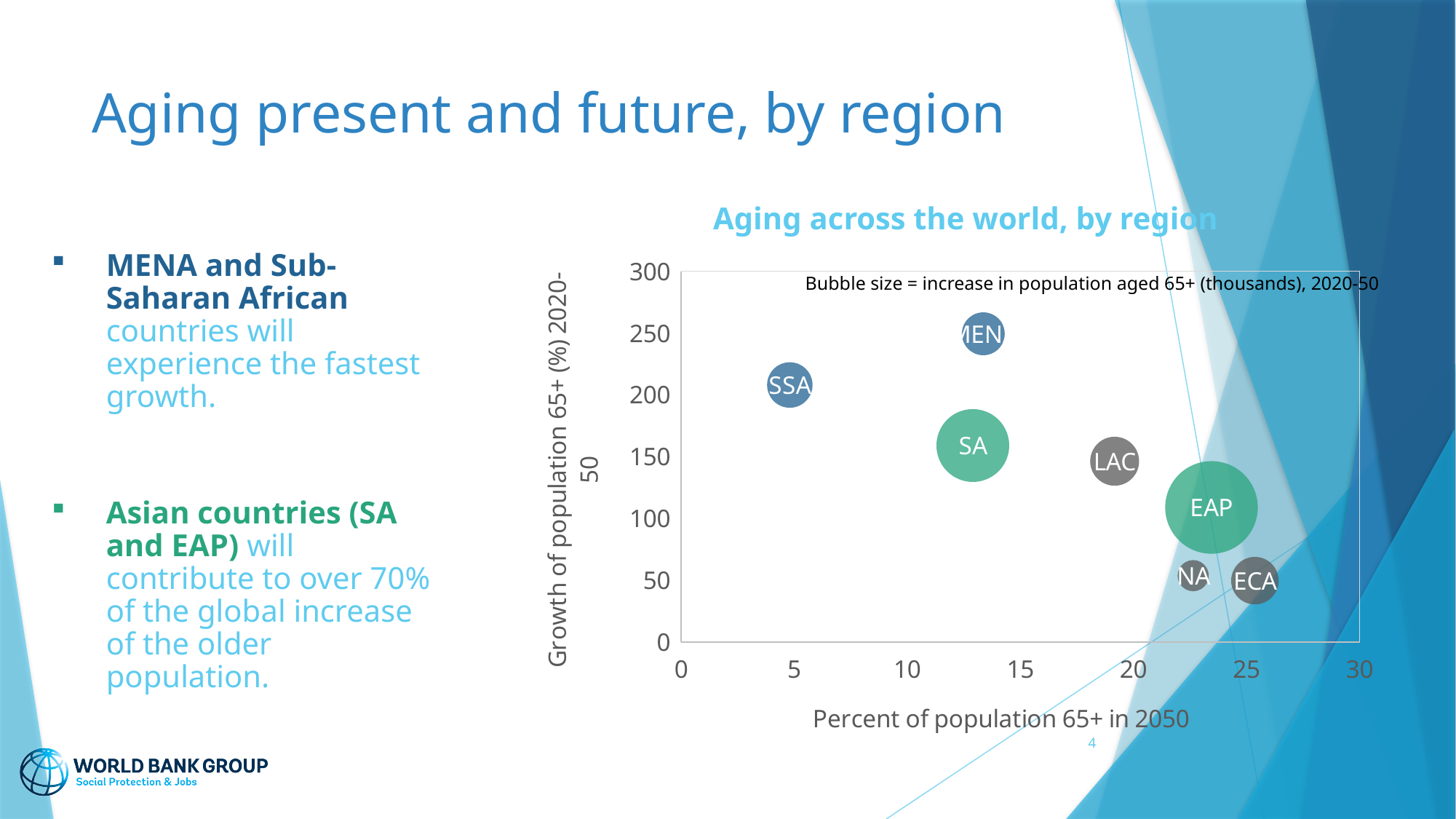
Which region has the highest growth of population 65+ (%) 2020-50? MENA Is the percent of population 65+ in 2050 for SSA greater or less than 10? less What is the title of the x axis of the chart? Percent of population 65+ in 2050 Is the growth of population 65+ for EAP greater or less than 150? less Is the percent of population 65+ in 2050 for EAP greater or less than 20? greater Which region has the largest bubble (largest increase in population aged 65+)? EAP How many region bubbles are plotted in the 'Aging across the world, by region' chart? 7 What does the bubble size represent in the chart? Increase in population aged 65+ (thousands), 2020-50 What kind of chart is shown on the slide? Bubble chart Which has a higher growth of population 65+ (%) 2020-50, SSA or LAC? SSA Which region has the lowest percent of population 65+ in 2050? SSA